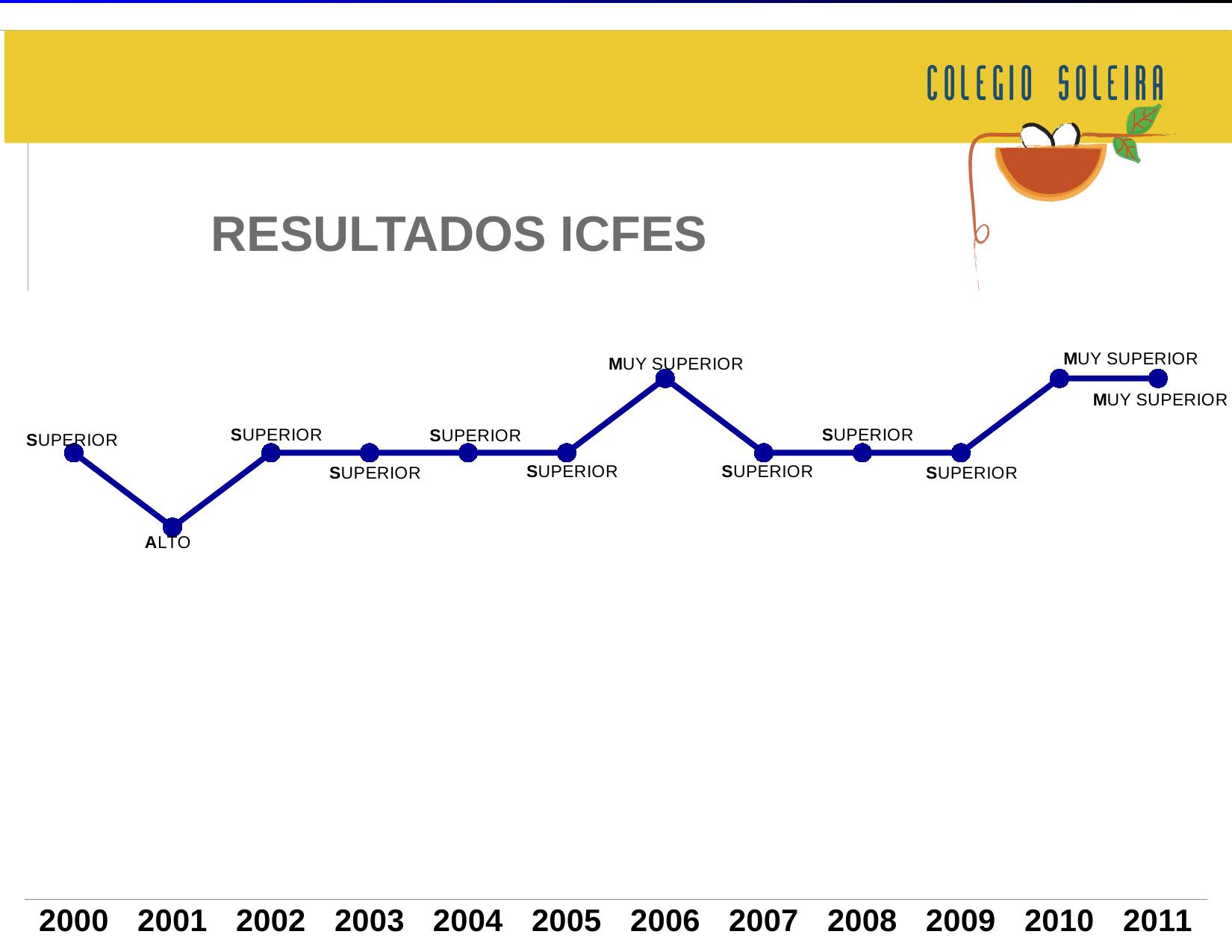
Does the line rise or fall from 2009 to 2010? Rises What is the title of the chart? RESULTADOS ICFES What is the ICFES result shown for 2000? SUPERIOR Which year has the lowest point on the line? 2001 How many years are shown on the x axis? 12 What is the ICFES result shown for 2011? MUY SUPERIOR What is the ICFES result shown for 2009? SUPERIOR Which year has the higher point on the line, 2006 or 2007? 2006 How many years are labelled MUY SUPERIOR? 3 What kind of chart is shown on the slide? Line chart What is the ICFES result shown for 2006? MUY SUPERIOR What is the ICFES result shown for 2001? ALTO